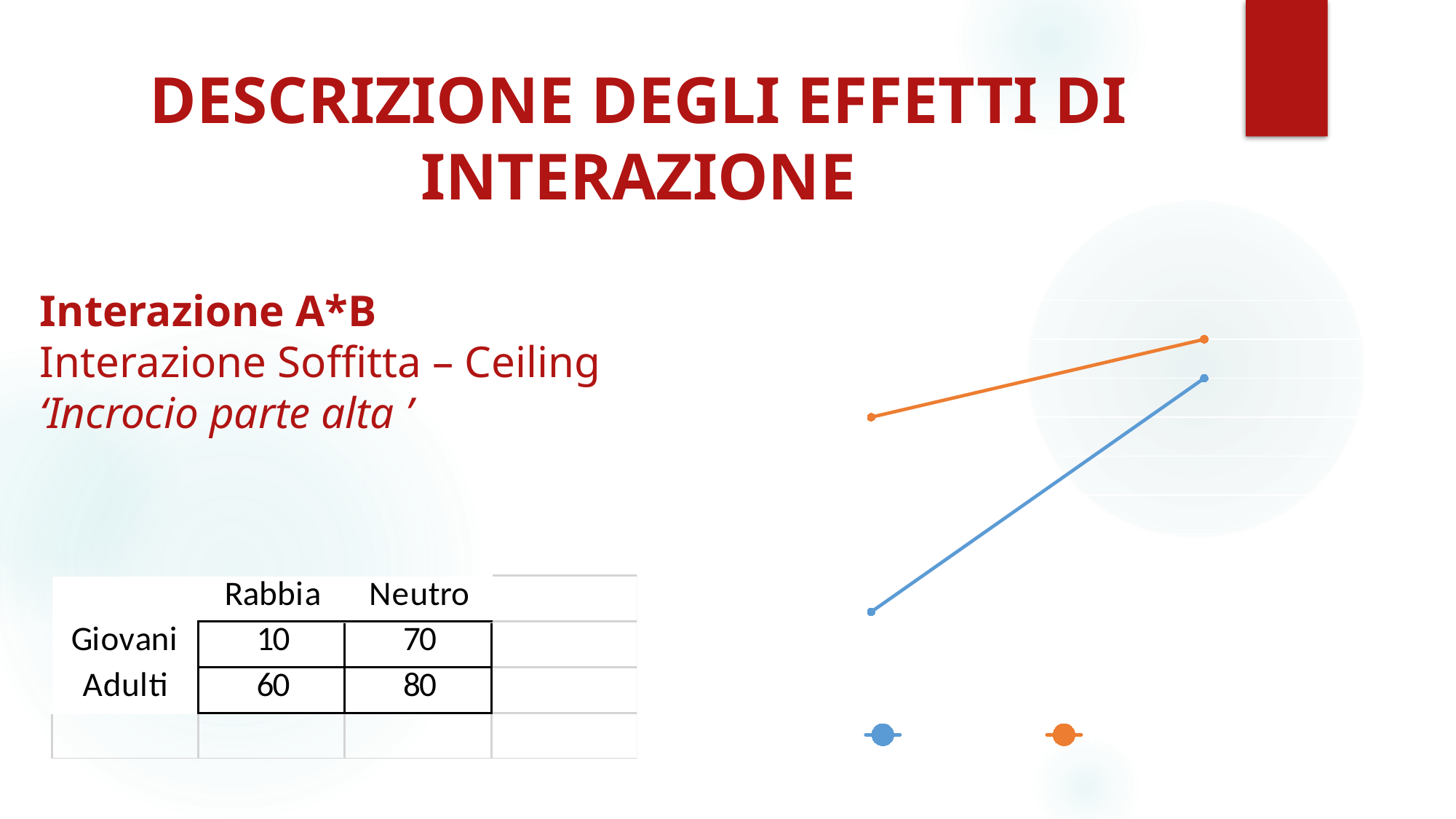
Does the blue line rise or fall from left to right? rise Which colours are used for the two lines in the chart? blue and orange How many data points does the orange line have? 2 Do the two lines in the chart cross each other? no What kind of chart is shown on the right of the slide? line chart Which line rises more steeply from left to right, the blue or the orange? blue At the right-hand point, which line is higher, the blue or the orange? orange How many series does the chart's legend show? 2 How many data points does the blue line have? 2 At the left-hand point, which line is higher, the blue or the orange? orange Does the orange line rise or fall from left to right? rise